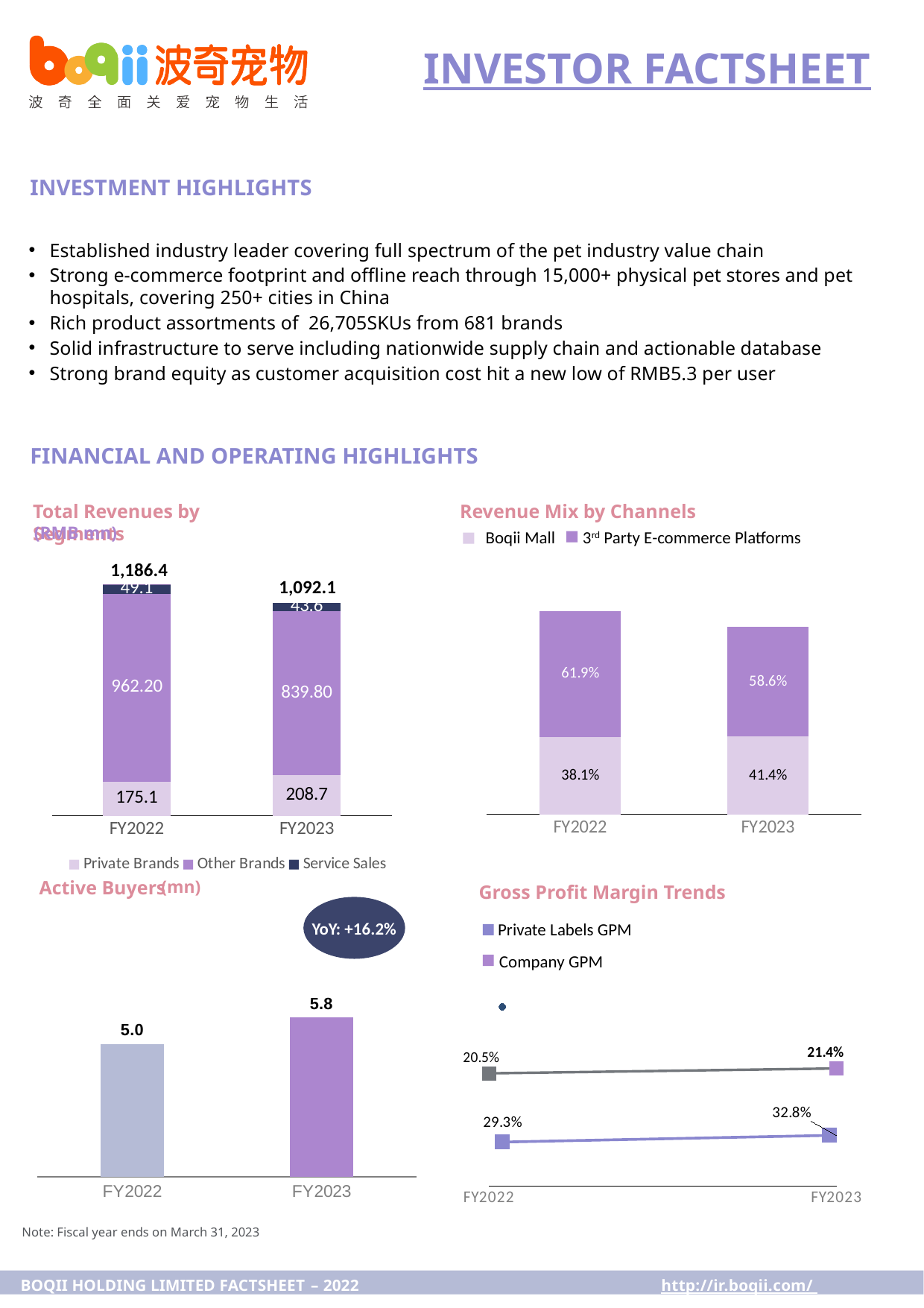
In the Total Revenues by Segments chart, how many series does the legend list? 3 In the Total Revenues by Segments chart, what is the Other Brands value for FY2023? 839.80 In the Total Revenues by Segments chart, which year has the higher Service Sales value, FY2022 or FY2023? FY2022 In the Revenue Mix by Channels chart, what share does Boqii Mall have in FY2023? 41.4% In the Active Buyers chart, what is the value for FY2023? 5.8 In the Revenue Mix by Channels chart, what is the 3rd Party E-commerce Platforms share for FY2022? 61.9% In the Total Revenues by Segments chart, what is the total revenue for FY2022? 1,186.4 In the Revenue Mix by Channels chart, does the Boqii Mall share rise or fall from FY2022 to FY2023? rise In the Total Revenues by Segments chart, what is the difference between the Private Brands values for FY2023 and FY2022? 33.6 In the Gross Profit Margin Trends chart, what is the FY2023 value on the line that starts at 29.3% in FY2022? 32.8% What kind of chart is the Gross Profit Margin Trends chart? line chart In the Active Buyers chart, what is the difference between the FY2023 and FY2022 values? 0.8